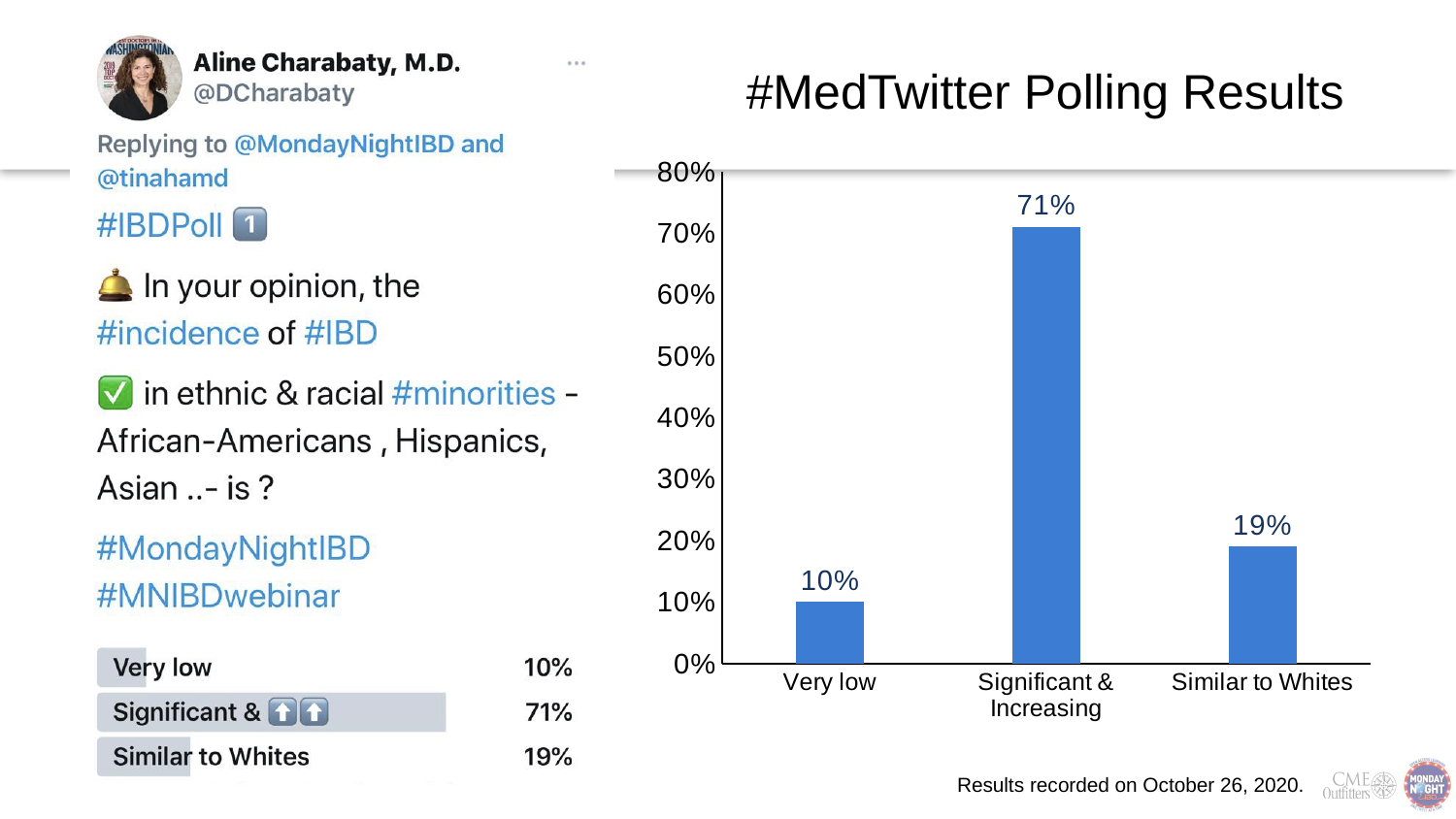
What percentage of respondents answered "Very low"? 10% What is the difference in percentage points between "Similar to Whites" and "Very low"? 9 How many response categories are shown on the chart? 3 Which response option received the highest percentage? Significant & Increasing Which received a larger share of responses, "Very low" or "Similar to Whites"? Similar to Whites What is the title of the chart? #MedTwitter Polling Results Which response option received the lowest percentage? Very low Is the value for "Significant & Increasing" greater or less than 60%? greater What percentage of respondents answered "Similar to Whites"? 19% What type of chart is used to show the polling results? Bar chart What is the difference in percentage points between "Significant & Increasing" and "Similar to Whites"? 52 What percentage of respondents answered "Significant & Increasing"? 71%